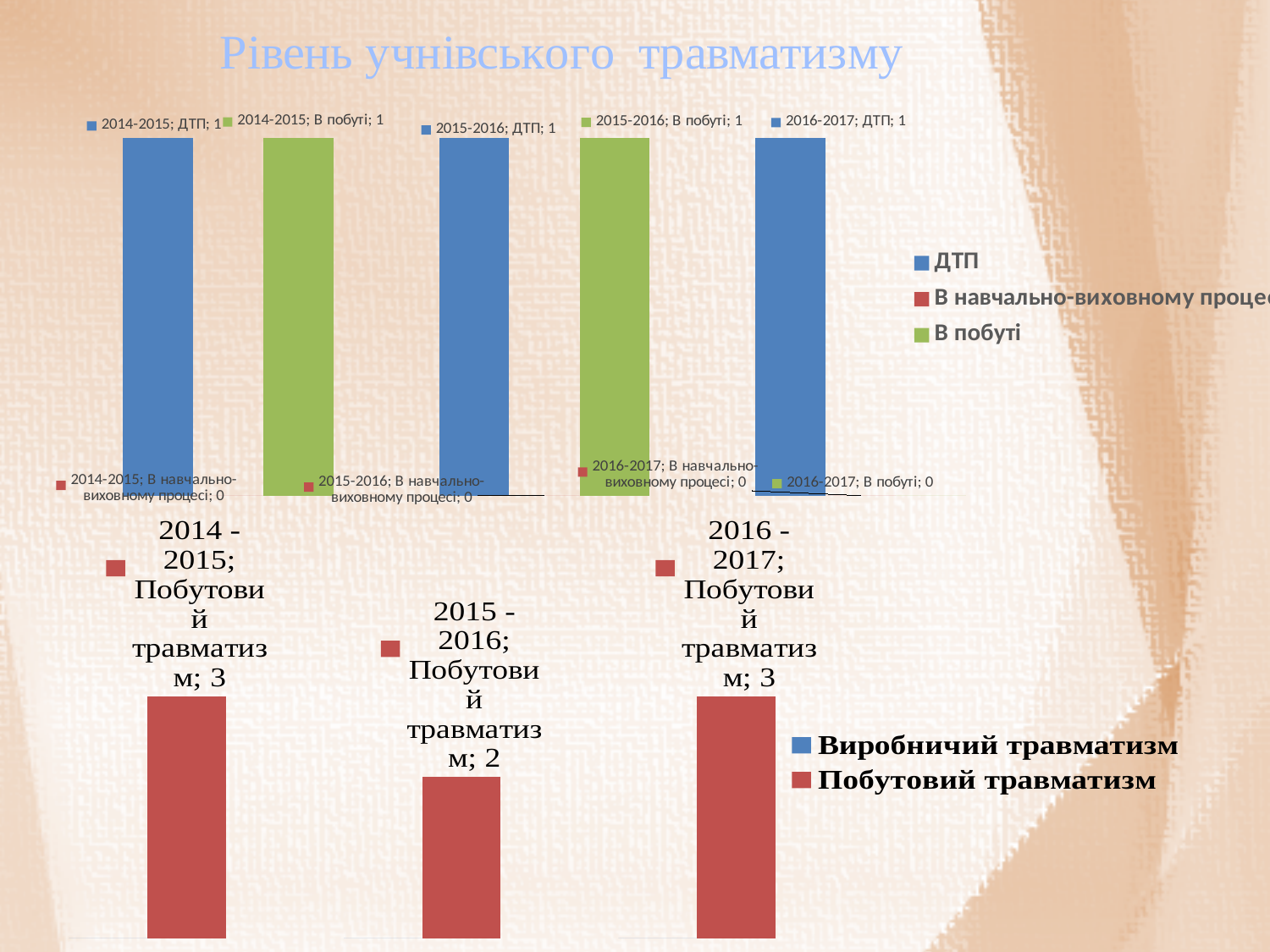
On the bottom chart, which year has the lowest value for Побутовий травматизм? 2015-2016 On the bottom chart, what is the value for Побутовий травматизм in 2016-2017? 3 On the top chart, what is the value for В побуті in 2016-2017? 0 What type of chart is the bottom chart? Bar chart On the top chart, how many series does the legend list? 3 On the top chart, what is the value for ДТП in 2014-2015? 1 On the bottom chart, what is the value for Побутовий травматизм in 2015-2016? 2 On the top chart, which is larger in 2016-2017: ДТП or В побуті? ДТП On the top chart, what is the value for В навчально-виховному процесі in 2015-2016? 0 On the bottom chart, how many series does the legend list? 2 On the top chart, what is the difference between В побуті in 2015-2016 and В побуті in 2016-2017? 1 On the bottom chart, what is the difference between Побутовий травматизм in 2014-2015 and in 2015-2016? 1